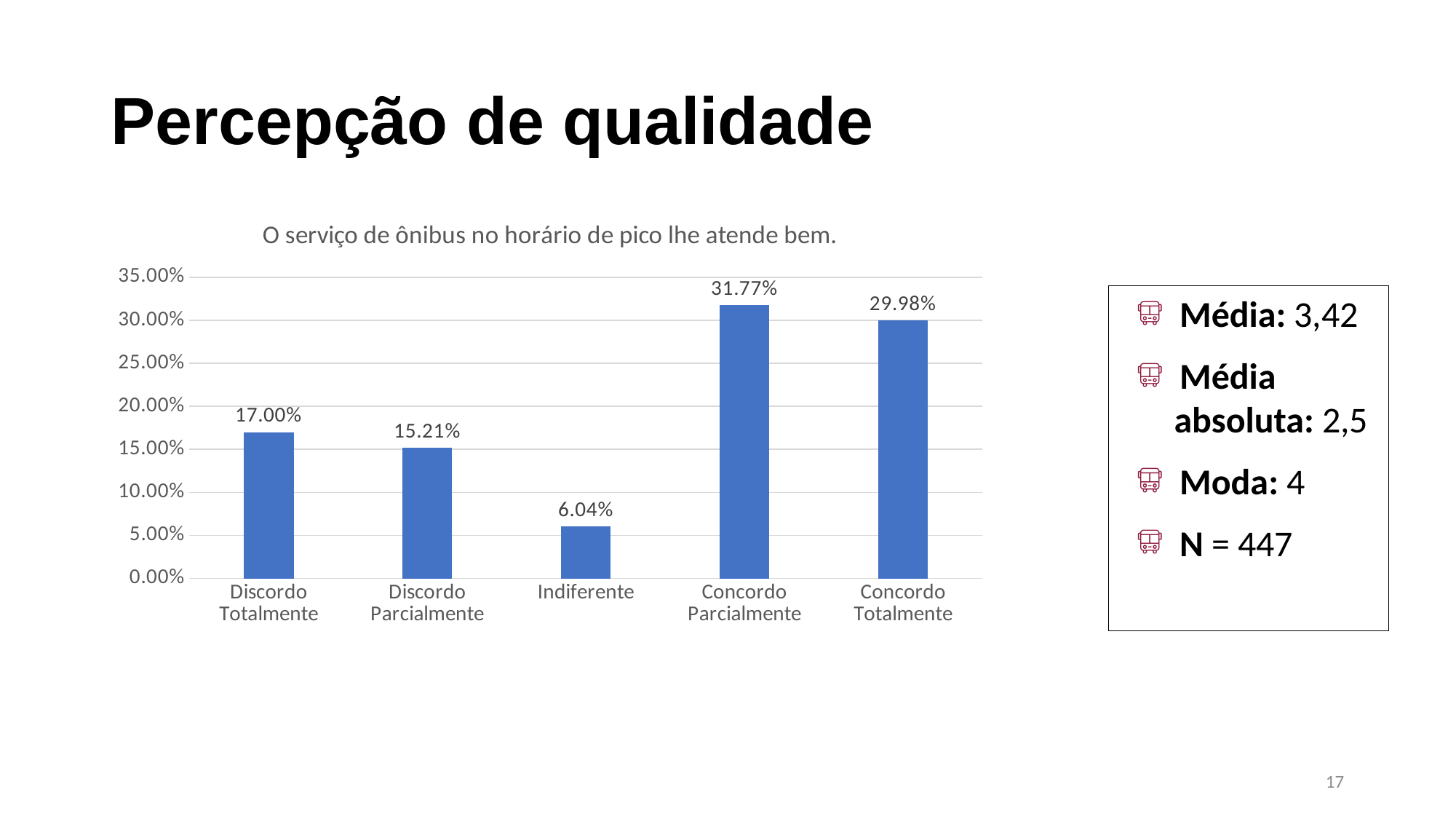
Is the value for Discordo Parcialmente greater or less than 20.00%? less What is the value for Indiferente? 6.04% What is the title of the chart? O serviço de ônibus no horário de pico lhe atende bem. Which is larger, Concordo Parcialmente or Concordo Totalmente? Concordo Parcialmente What is the value for Concordo Parcialmente? 31.77% Which category has the lowest value? Indiferente What is the difference between Discordo Totalmente and Discordo Parcialmente? 1.79% What is the value for Discordo Totalmente? 17.00% What is the value for Concordo Totalmente? 29.98% What kind of chart is shown on the slide? bar chart How many categories are shown on the x axis? 5 Which category has the highest value? Concordo Parcialmente